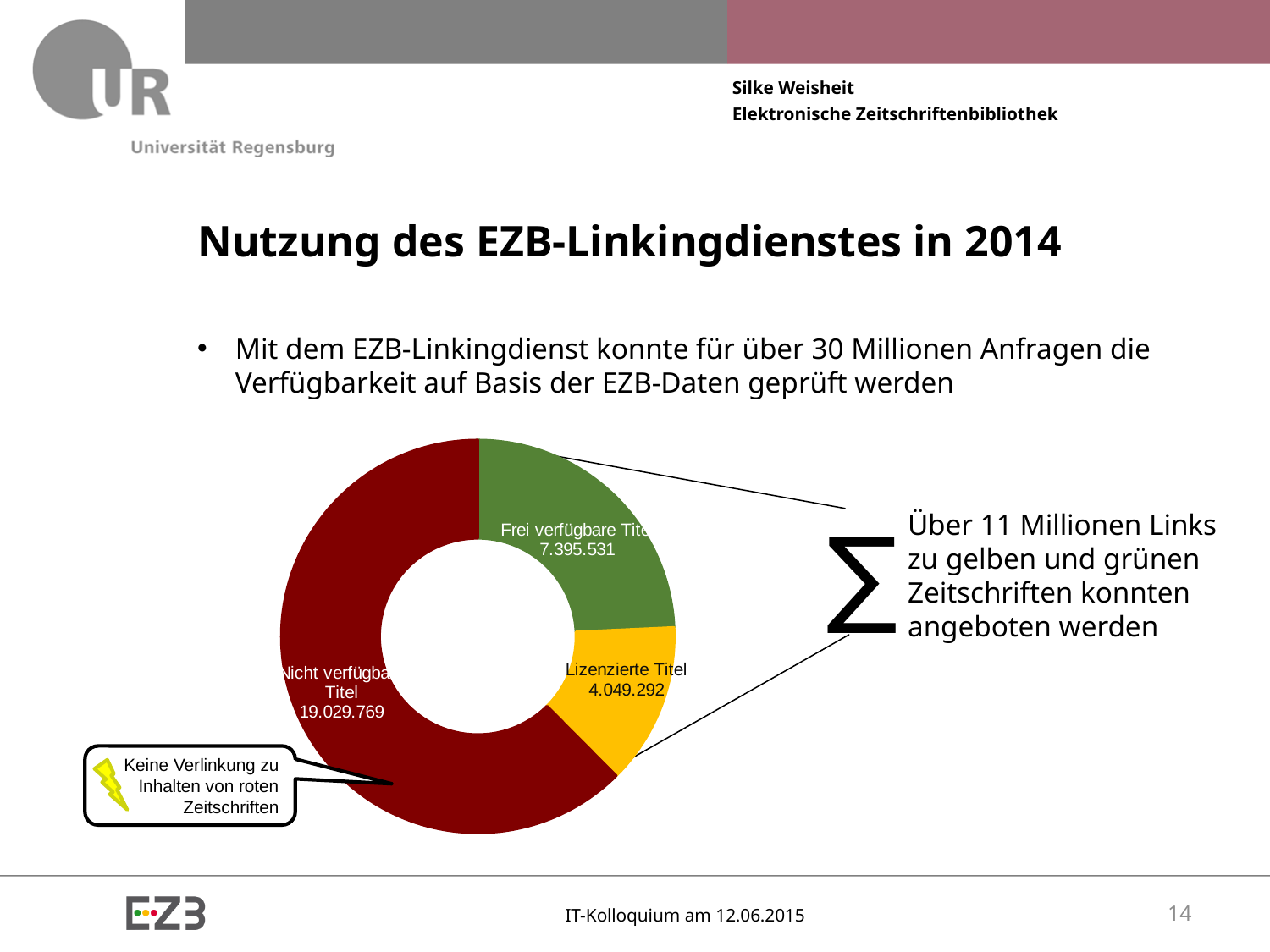
What is the combined value of Frei verfügbare Titel and Lizenzierte Titel? 11.444.823 What value is shown for Lizenzierte Titel? 4.049.292 Which category has the smallest value in the chart? Lizenzierte Titel What kind of chart is shown on the slide? doughnut chart What value is shown for Nicht verfügbare Titel? 19.029.769 Which category has the largest value in the chart? Nicht verfügbare Titel What colour is the segment for Lizenzierte Titel? yellow Which is larger, the value for Frei verfügbare Titel or the value for Lizenzierte Titel? Frei verfügbare Titel What is the difference between the values for Nicht verfügbare Titel and Frei verfügbare Titel? 11.634.238 What is the difference between the values for Frei verfügbare Titel and Lizenzierte Titel? 3.346.239 What value is shown for Frei verfügbare Titel? 7.395.531 How many categories does the chart show? 3